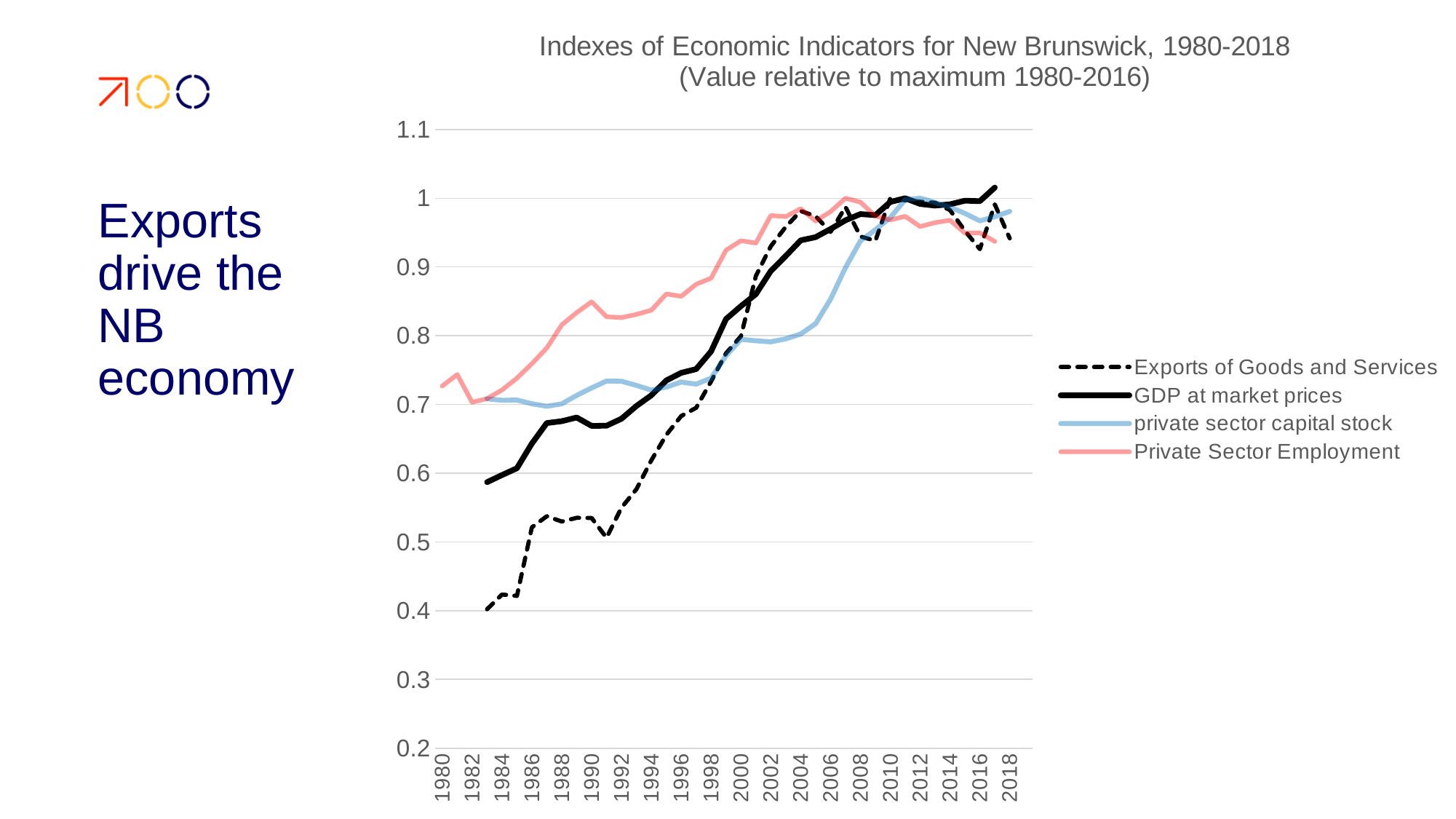
Is the value for Private Sector Employment in 2007 greater or less than 0.9? greater What kind of chart is shown on the slide? line chart In 2000, which is larger: Private Sector Employment or GDP at market prices? Private Sector Employment How many series does the legend list? 4 Which series has the highest value in 1990? Private Sector Employment Is the value for Exports of Goods and Services in 1990 greater or less than 0.5? greater What is the title of the chart? Indexes of Economic Indicators for New Brunswick, 1980-2018 (Value relative to maximum 1980-2016) Which series is drawn with a dashed black line? Exports of Goods and Services Is the value for private sector capital stock in 1990 greater or less than 0.7? greater